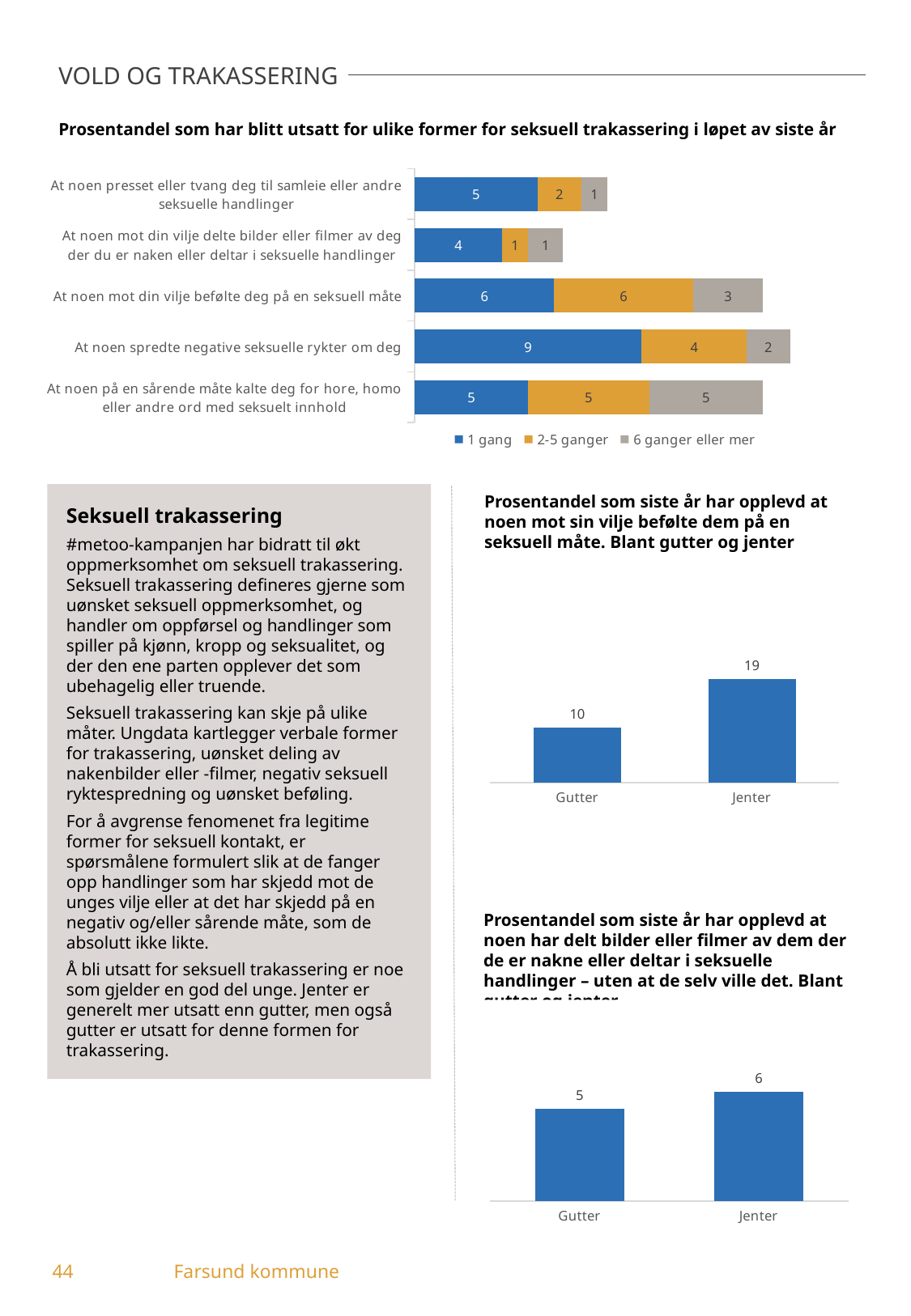
In the top chart, what is the total of the stacked bar for 'At noen på en sårende måte kalte deg for hore, homo eller andre ord med seksuelt innhold'? 15 What kind of chart is the top chart on the slide? Stacked bar chart How many categories are shown in the top chart? 5 In the bottom-right chart about delte bilder eller filmer, what is the value for Gutter? 5 In the top chart, which category has the highest value for '1 gang'? At noen spredte negative seksuelle rykter om deg In the chart titled 'Prosentandel som siste år har opplevd at noen mot sin vilje befølte dem på en seksuell måte', what is the difference between Jenter and Gutter? 9 In the top chart, what is the total of the stacked bar for 'At noen mot din vilje delte bilder eller filmer av deg der du er naken eller deltar i seksuelle handlinger'? 6 In the top chart, what is the value for '6 ganger eller mer' for 'At noen mot din vilje befølte deg på en seksuell måte'? 3 In the chart titled 'Prosentandel som siste år har opplevd at noen mot sin vilje befølte dem på en seksuell måte', what is the value for Jenter? 19 In the bottom-right chart about delte bilder eller filmer, which is larger, Gutter or Jenter? Jenter How many series does the legend of the top chart list? 3 In the top chart, what is the value for '1 gang' for 'At noen spredte negative seksuelle rykter om deg'? 9